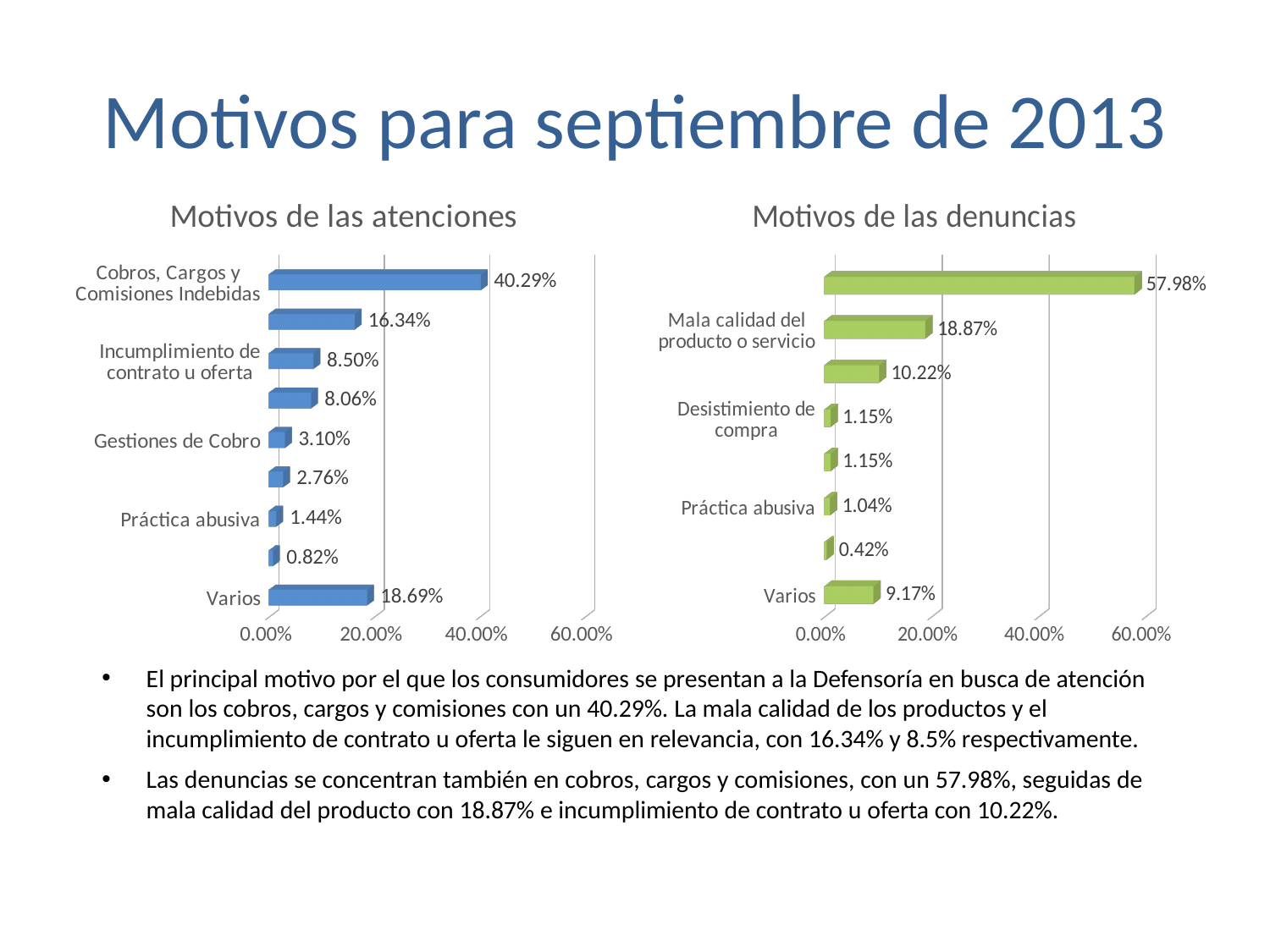
In the 'Motivos de las atenciones' chart, what is the difference between Gestiones de Cobro and Práctica abusiva? 1.66% In the 'Motivos de las atenciones' chart, what is the value for Cobros, Cargos y Comisiones Indebidas? 40.29% What kind of chart is 'Motivos de las denuncias'? Bar chart In the 'Motivos de las denuncias' chart, what is the value for Mala calidad del producto o servicio? 18.87% In the 'Motivos de las atenciones' chart, what is the value for Varios? 18.69% In the 'Motivos de las denuncias' chart, what is the value for Varios? 9.17% In the 'Motivos de las atenciones' chart, what is the value for Incumplimiento de contrato u oferta? 8.50% In the 'Motivos de las denuncias' chart, which is larger, Desistimiento de compra or Práctica abusiva? Desistimiento de compra In the 'Motivos de las atenciones' chart, which category has the highest value? Cobros, Cargos y Comisiones Indebidas In the 'Motivos de las denuncias' chart, what is the highest value shown? 57.98% In the 'Motivos de las atenciones' chart, how many bars are plotted? 9 In the 'Motivos de las denuncias' chart, what is the lowest value shown? 0.42%